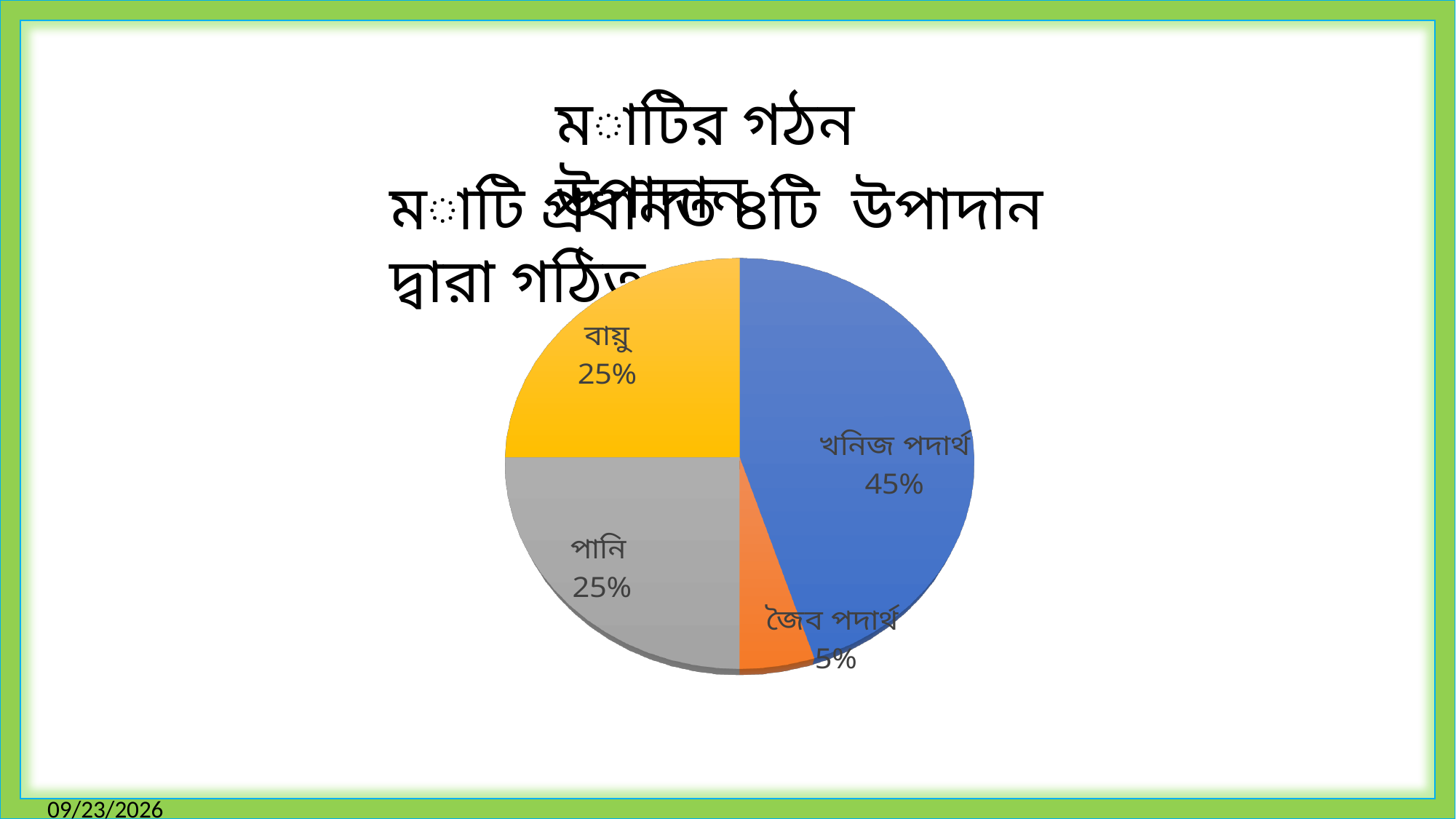
Which slice of the pie chart is the largest? খনিজ পদার্থ What colour is the slice for খনিজ পদার্থ? blue What percentage of the pie is labelled বায়ু? 25% What is the combined share of পানি and বায়ু in the pie chart? 50% What kind of chart is shown on the slide? pie chart What percentage of the pie is labelled খনিজ পদার্থ? 45% What percentage of the pie is labelled পানি? 25% What percentage of the pie is labelled জৈব পদার্থ? 5% Which slice of the pie chart is the smallest? জৈব পদার্থ How many slices does the pie chart have? 4 Which is larger, the slice for খনিজ পদার্থ or the slice for পানি? খনিজ পদার্থ What is the difference in percentage points between খনিজ পদার্থ and জৈব পদার্থ? 40